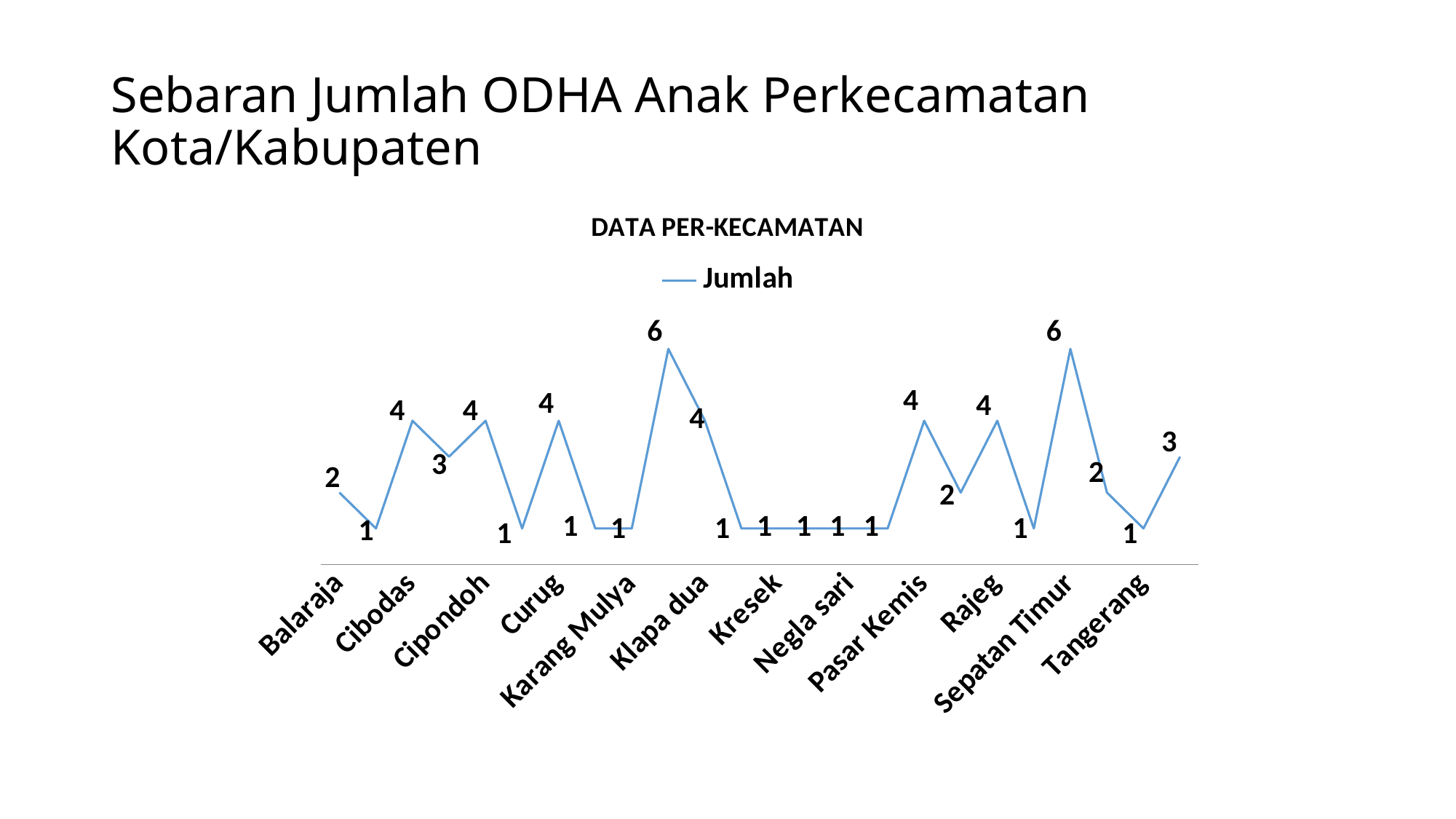
What is the lowest value plotted on the line? 1 What is the value for Sepatan Timur? 6 What is the name of the series shown in the legend? Jumlah What is the highest value plotted on the line? 6 How many series does the legend list? 1 Which has the larger value, Balaraja or Sepatan Timur? Sepatan Timur How many category labels are shown along the x axis? 12 What is the value for Balaraja? 2 What is the difference between the highest and lowest values plotted on the line? 5 How many data points on the line have a value of 6? 2 What is the title of the chart? DATA PER-KECAMATAN What kind of chart is shown on the slide? line chart